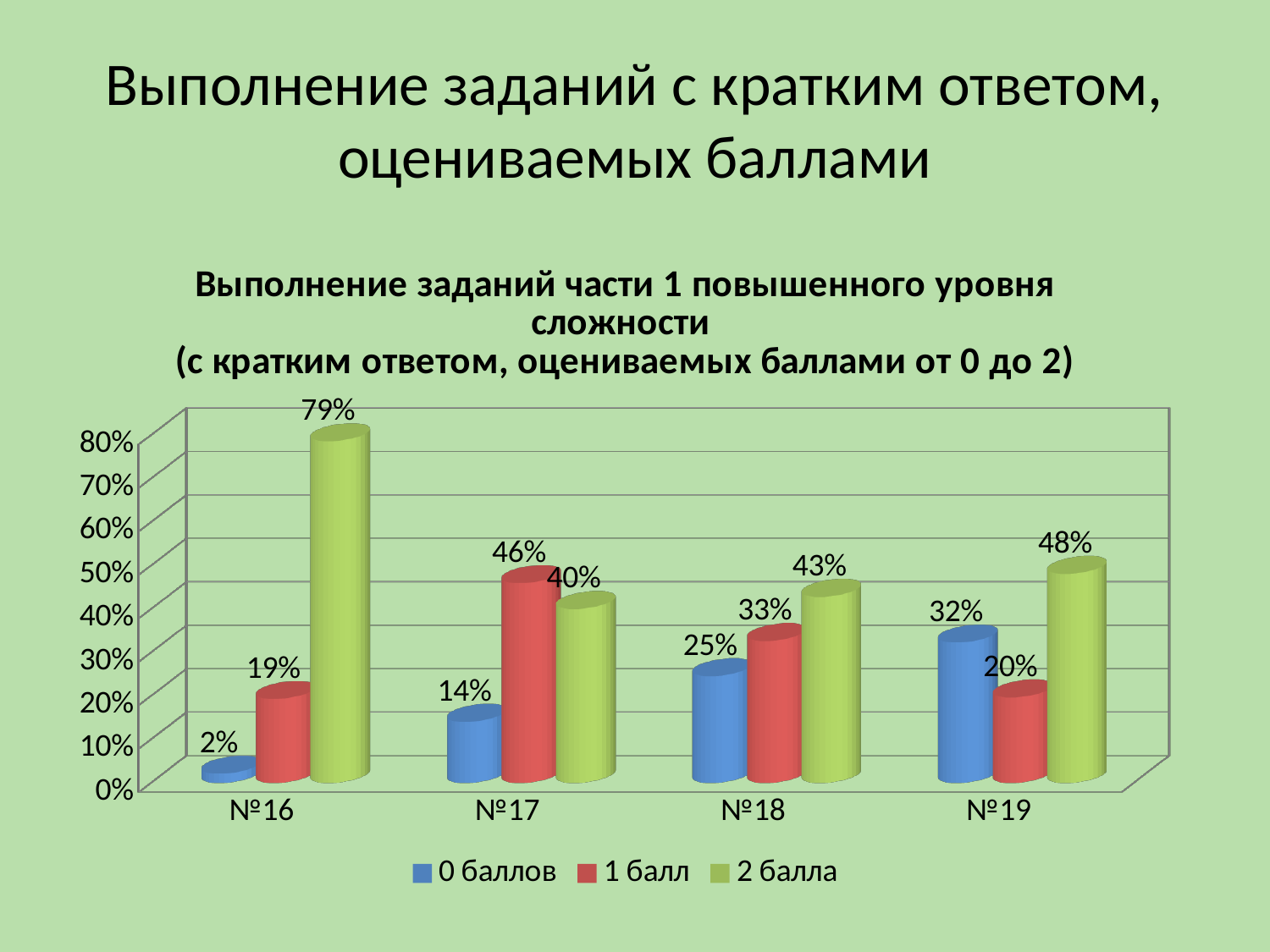
What is the value for "0 баллов" for №17? 14% Which is larger for №17: "1 балл" or "2 балла"? 1 балл Do the "0 баллов" values rise or fall from №16 to №19? rise How many categories are shown on the x axis? 4 Which category has the highest value for "0 баллов"? №19 What kind of chart is shown? bar chart What is the value for "1 балл" for №18? 33% Which category has the lowest value for "2 балла"? №17 What colour are the "2 балла" bars? green What is the value for "2 балла" for №16? 79% What is the difference between the "2 балла" values for №16 and №19? 31% How many series does the legend list? 3